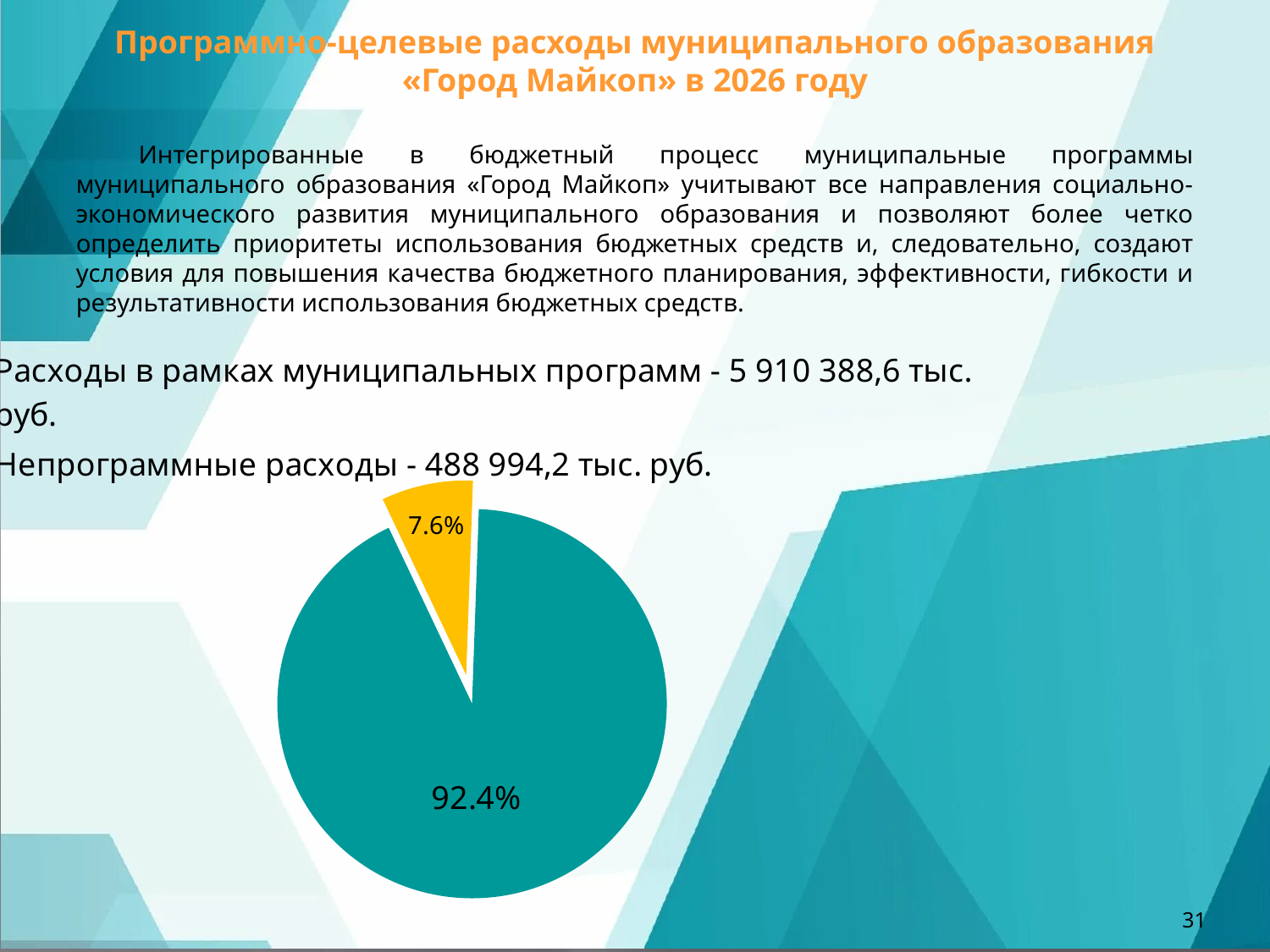
What share of the pie does the smaller (yellow) slice represent? 7.6% What colour is the slice labelled 7.6%? yellow What kind of chart is shown on the slide? pie chart According to the slide text, what is the amount of expenses within municipal programmes (Расходы в рамках муниципальных программ)? 5 910 388,6 тыс. руб. Is the share of the yellow slice greater or less than 10%? less Which slice is larger, the teal one or the yellow one? the teal one What is the largest value shown on the pie chart? 92.4% What share of the pie does the larger (teal) slice represent? 92.4% By how many percentage points does the larger slice exceed the smaller slice? 84.8 percentage points What is the smallest value shown on the pie chart? 7.6% Is the share of the teal slice greater or less than 90%? greater How many slices does the pie chart have? 2